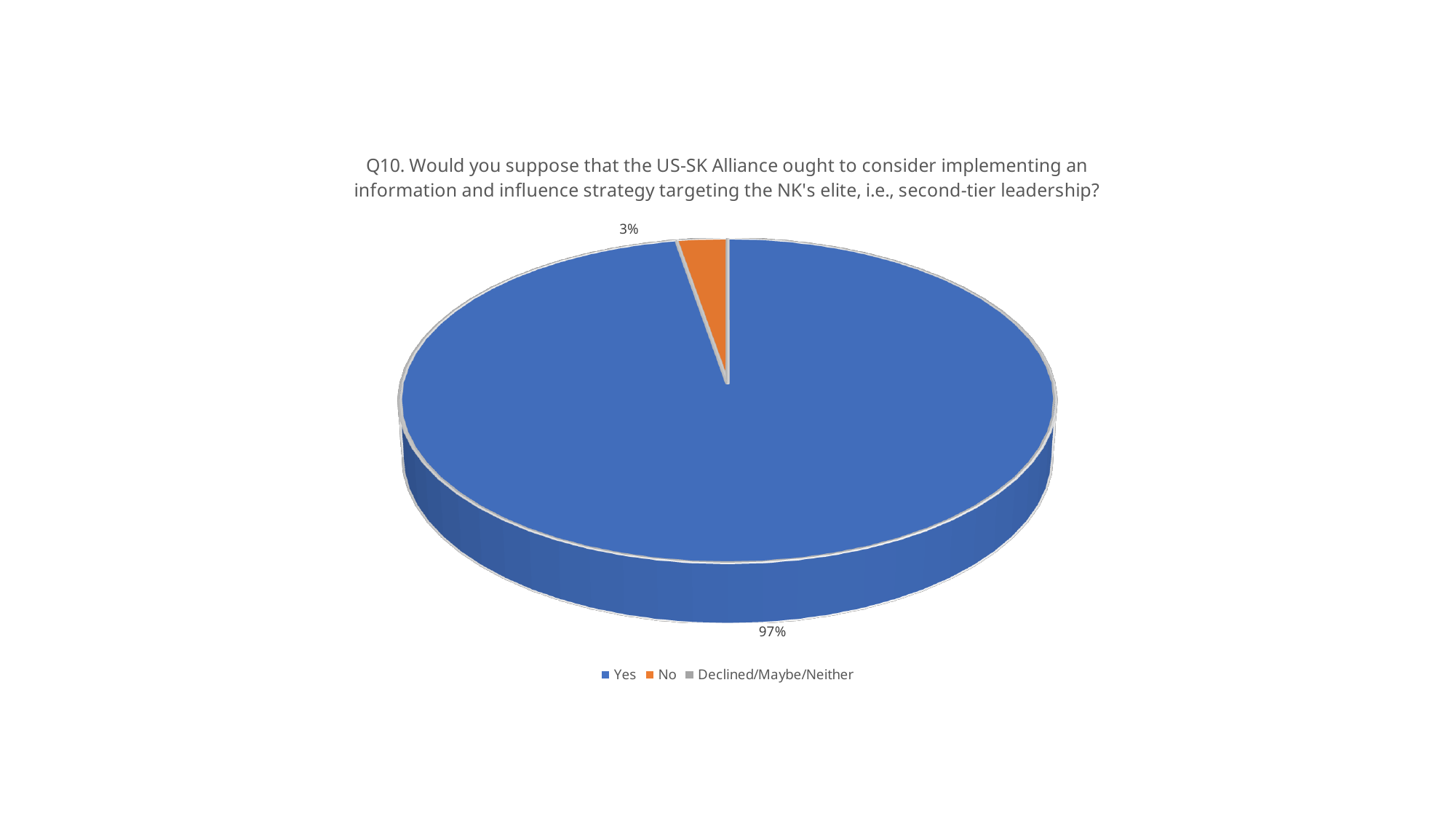
Is the share for No greater or less than 10%? less What share of the pie is labelled for Yes? 97% Is the share for Yes greater or less than 90%? greater What kind of chart is shown on the slide? Pie chart Which of the visible slices is the smallest? No Which is larger, the Yes slice or the No slice? Yes What colour is the Yes slice? Blue What is the difference in percentage points between the Yes and No slices? 94 How many categories does the legend list? 3 Which category has the largest slice of the pie? Yes What colour is the No slice? Orange What share of the pie is labelled for No? 3%